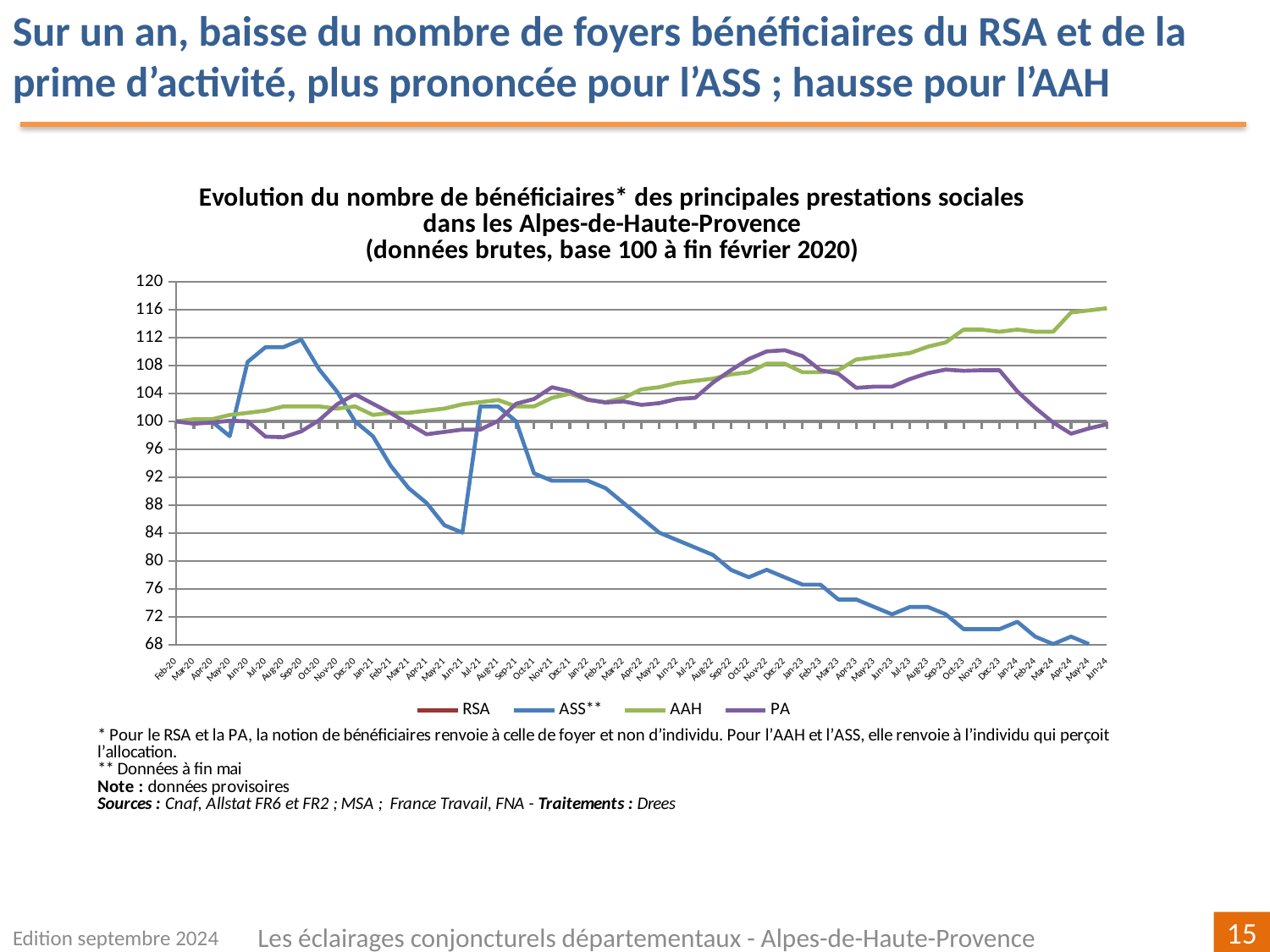
How many series does the legend list? 4 Which series are listed in the legend? RSA, ASS**, AAH, PA What kind of chart is shown on the slide? line chart Does the ASS** series overall rise or fall between Feb-20 and Jun-24? fall Which series has the highest value in Jun-24? AAH Is the value for PA in Dec-22 greater or less than 108? greater Is the value for AAH in Jun-24 greater or less than 112? greater Is the value for ASS** in Sep-20 greater or less than 108? greater What is the base value of the index at the end of February 2020, according to the chart title? 100